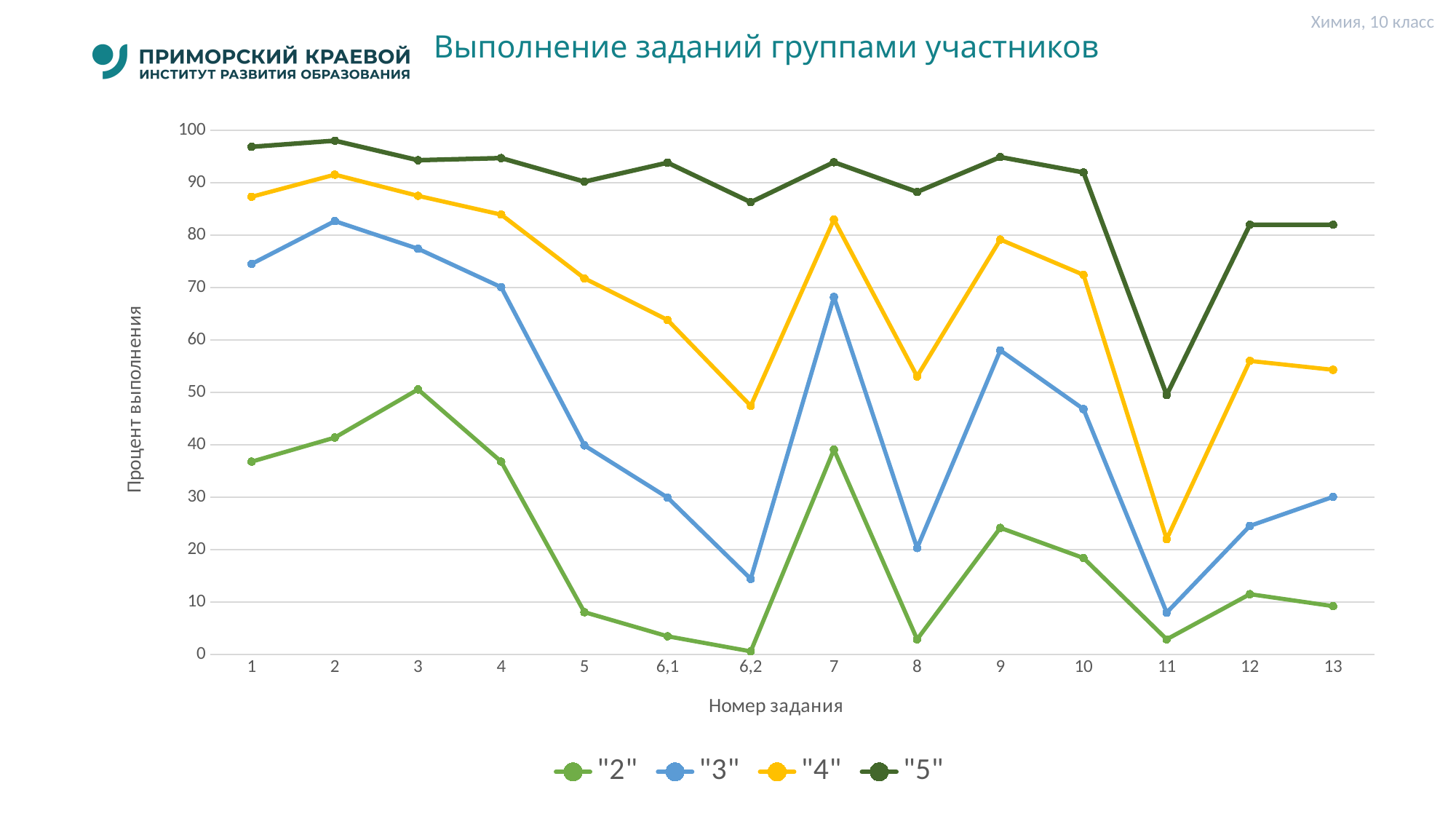
For series "4", which task number has the lowest value? 11 For series "3", which task number has the highest value? 2 Is the value for series "3" at task 7 greater or less than 60? greater Is the value for series "5" at task 11 greater or less than 60? less For series "5", which task number has the lowest value? 11 What kind of chart is shown on the slide? line chart For series "2", which task number has the highest value? 3 At task 12, which series has the larger value, "5" or "4"? "5" How many task numbers are plotted along the x axis? 14 What is the label of the y axis? Процент выполнения How many series does the legend list? 4 Does series "2" rise or fall from task 3 to task 6,2? fall